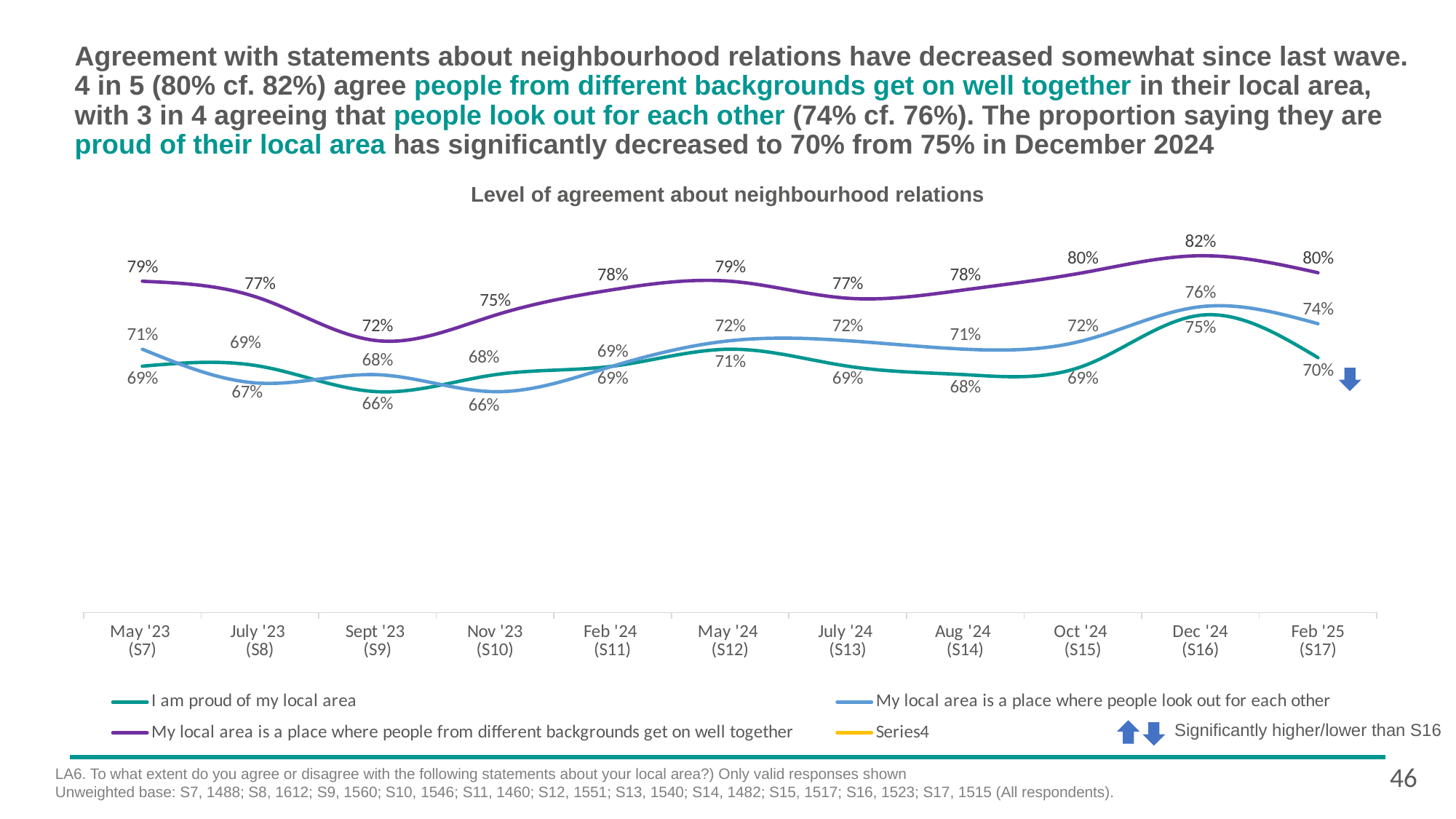
What is the title of the chart? Level of agreement about neighbourhood relations By how many percentage points did 'I am proud of my local area' fall from Dec '24 (S16) to Feb '25 (S17)? 5 percentage points What is the value for 'I am proud of my local area' in Sept '23 (S9)? 66% How many series does the legend list? 4 In Feb '25 (S17), which is higher: 'I am proud of my local area' or 'My local area is a place where people look out for each other'? My local area is a place where people look out for each other In which wave is 'My local area is a place where people from different backgrounds get on well together' at its highest? Dec '24 (S16) What is the value for 'My local area is a place where people from different backgrounds get on well together' in Dec '24 (S16)? 82% How many survey waves (points) are plotted along the x axis? 11 What kind of chart is shown on the slide? Line chart What is the value for 'My local area is a place where people look out for each other' in Feb '25 (S17)? 74% What is the value for 'I am proud of my local area' in Feb '25 (S17)? 70% In which wave is 'My local area is a place where people from different backgrounds get on well together' at its lowest? Sept '23 (S9)